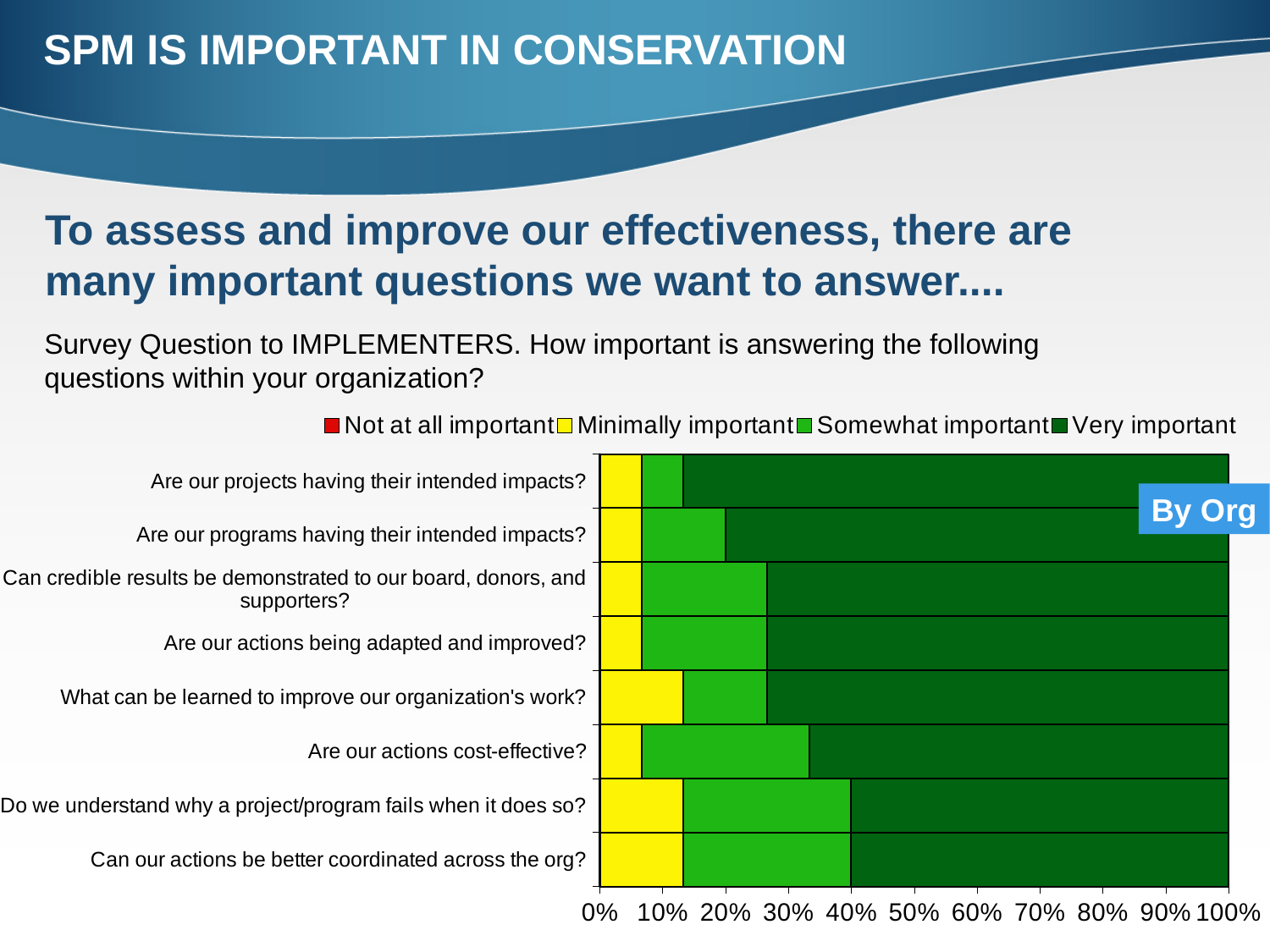
How many series does the chart legend list? 4 How many survey questions (categories) are plotted on the chart? 8 Is the 'Somewhat important' share for 'Are our actions cost-effective?' greater or less than 20%? greater What is the label on the blue box at the right of the chart? By Org Is the 'Very important' share for 'Can our actions be better coordinated across the org?' greater or less than 70%? less What kind of chart is shown on the slide? Stacked bar chart Which has the larger 'Very important' share: 'Are our projects having their intended impacts?' or 'Can our actions be better coordinated across the org?' Are our projects having their intended impacts? Which category has the largest 'Very important' share? Are our projects having their intended impacts? Is the 'Minimally important' share for 'Are our projects having their intended impacts?' greater or less than 10%? less What is the total of each stacked bar on the chart? 100% Which series is shown in dark green in the legend? Very important